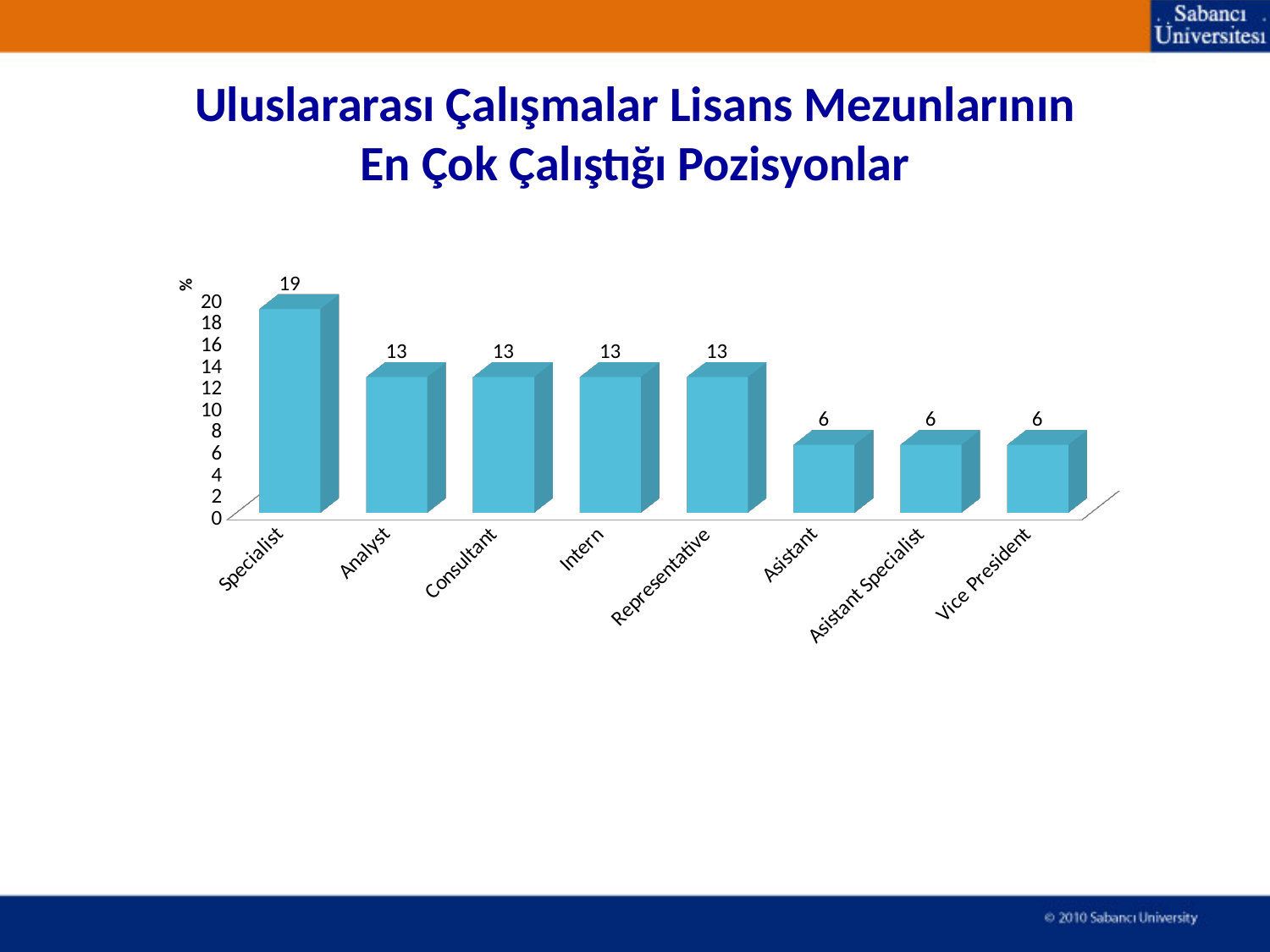
What is the value for Vice President? 6 What is the difference between the values for Specialist and Intern? 6 How many categories are shown in the chart? 8 What kind of chart is shown on the slide? bar chart What is the value for Analyst? 13 What is the value for Specialist? 19 Which category has the highest value? Specialist Is the value for Specialist greater or less than 16? greater What unit is shown on the vertical axis label? % What is the difference between the values for Consultant and Asistant? 7 Which is larger, the value for Analyst or the value for Asistant Specialist? Analyst What is the value for Representative? 13